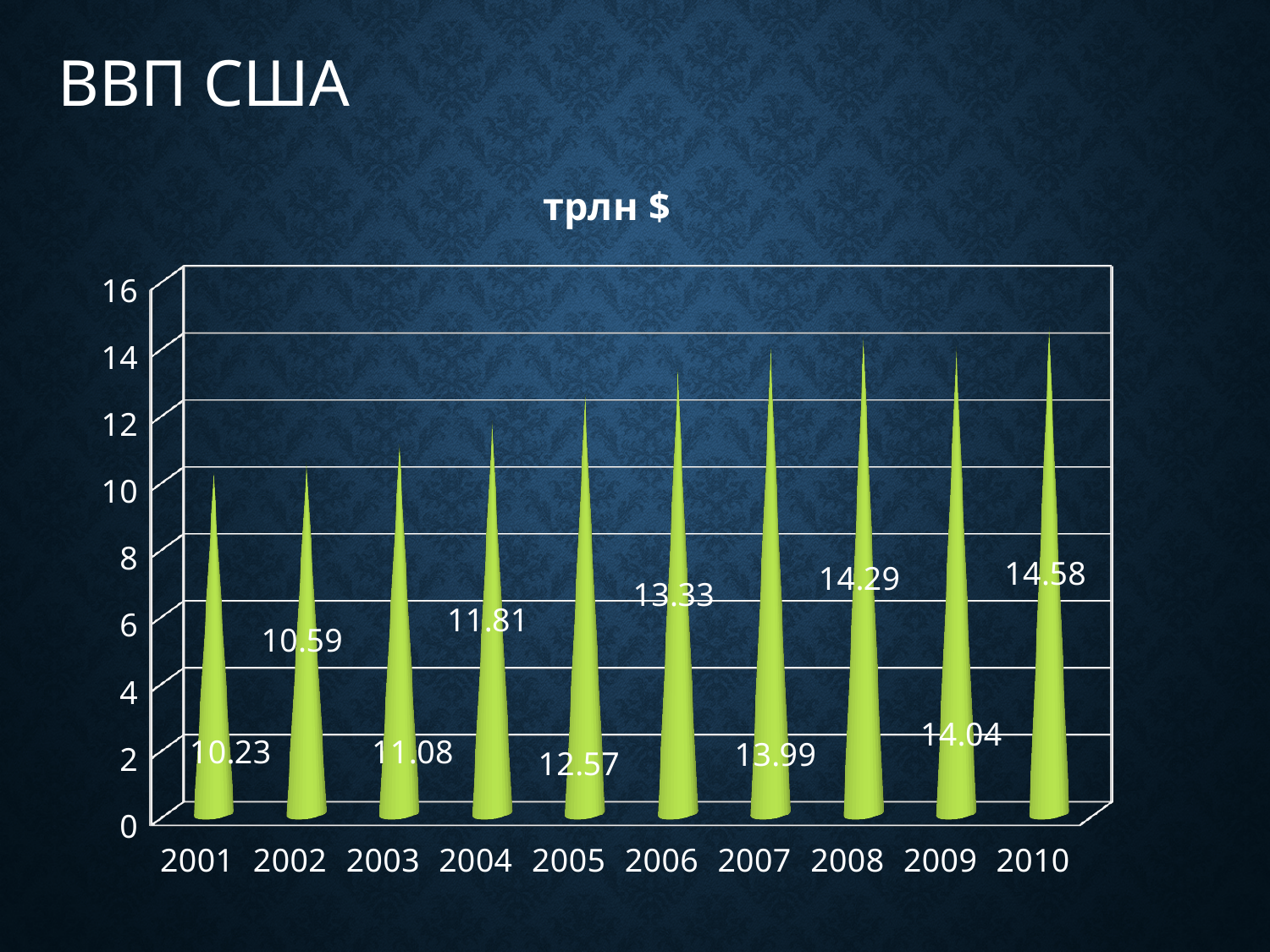
What is the title of the chart? трлн $ What is the value for 2006? 13.33 How many years are shown on the x axis? 10 What is the value for 2001? 10.23 What is the value for 2009? 14.04 What is the difference between the values for 2010 and 2001? 4.35 Which year has the lowest value? 2001 Which is larger, the value for 2008 or the value for 2009? 2008 Which year has the highest value? 2010 Is the value for 2005 greater or less than 12? greater What kind of chart is this? bar chart What is the difference between the values for 2008 and 2009? 0.25